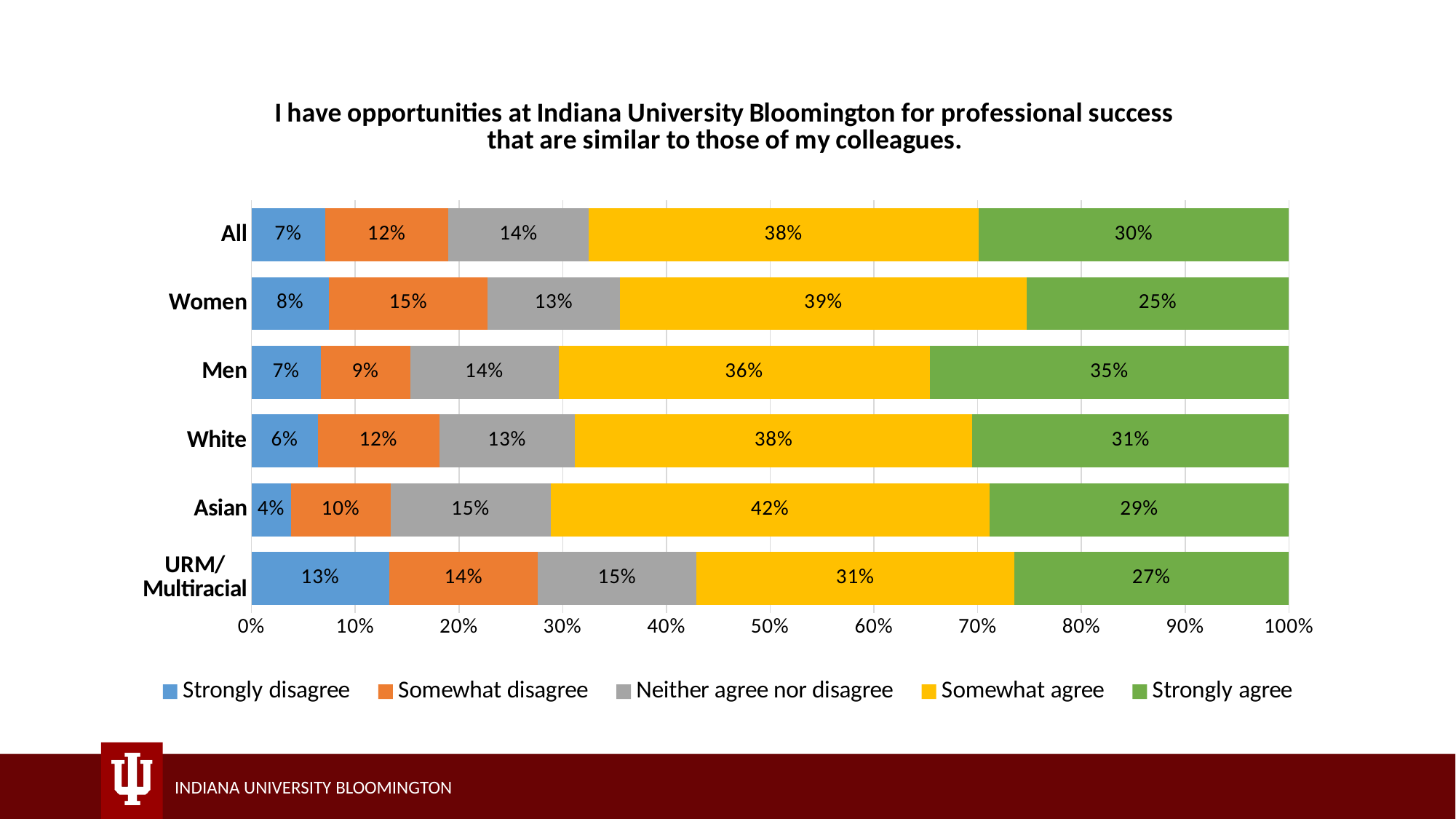
How many series does the legend list? 5 What is the combined percentage of Men who somewhat agree or strongly agree? 71% Which group has the lowest Strongly disagree percentage? Asian What percentage of URM/Multiracial respondents strongly disagree? 13% Which group has the highest Strongly agree percentage? Men How many groups are shown on the chart? 6 What is the difference between the Somewhat agree percentages for Asian and URM/Multiracial respondents? 11% What percentage of Asian respondents strongly agree? 29% Which is larger: the Somewhat disagree percentage for Women or for Men? Women What percentage of Women somewhat agree? 39% What colour represents Neither agree nor disagree? Gray What kind of chart is shown? Stacked bar chart